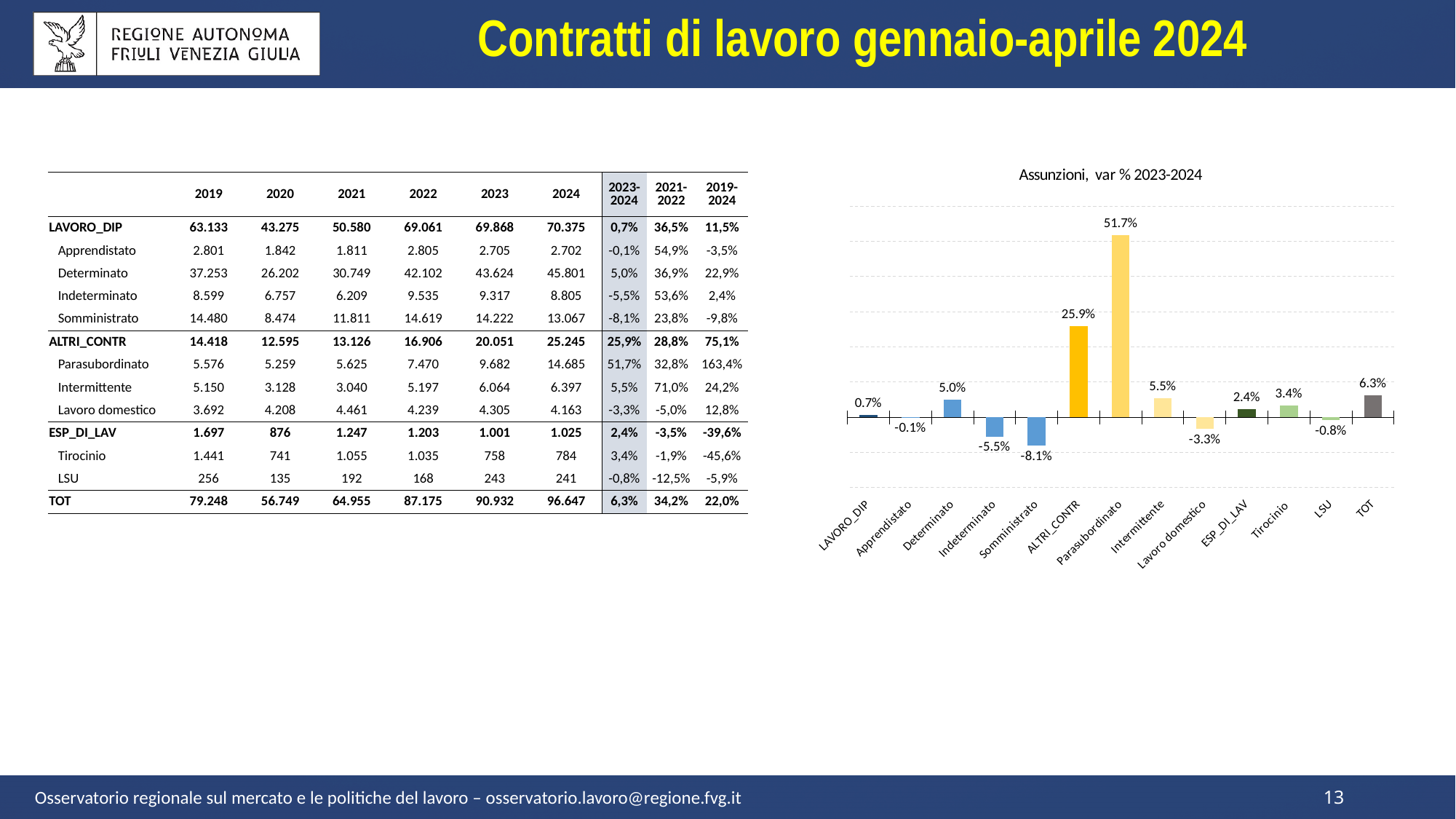
What is the difference between the values for Tirocinio and LSU? 4.2% What is the value for Parasubordinato in the chart? 51.7% What kind of chart is shown on the slide? Bar chart Which category has the lowest value in the chart? Somministrato What is the value for Lavoro domestico in the chart? -3.3% What is the title of the chart? Assunzioni, var % 2023-2024 How many categories are shown in the chart? 13 What is the value for TOT in the chart? 6.3% Which is larger, the value for Determinato or the value for Intermittente? Intermittente Which category has the highest value in the chart? Parasubordinato What is the value for Somministrato in the chart? -8.1% What is the difference between the values for Parasubordinato and ALTRI_CONTR? 25.8%